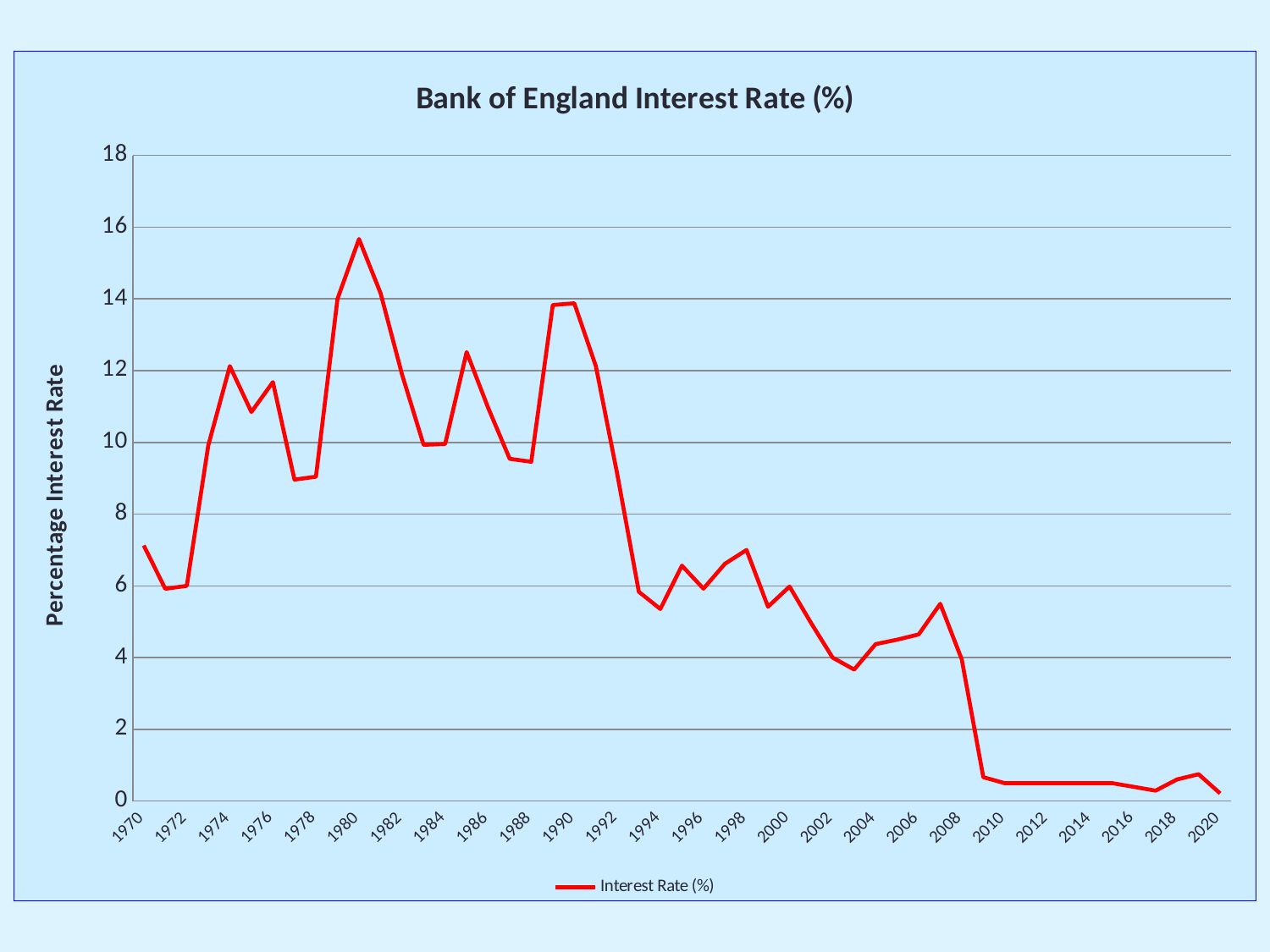
What is the label on the vertical axis? Percentage Interest Rate Is the interest rate for 2000 greater or less than 8? less Is the interest rate for 2010 greater or less than 2? less Which year has the higher interest rate, 1980 or 1990? 1980 How many series does the legend list? 1 What is the title of the chart? Bank of England Interest Rate (%) Does the interest rate rise or fall between 2008 and 2010? fall Is the interest rate for 1974 greater or less than 10? greater In which year does the interest rate reach its highest value? 1980 Which year has the higher interest rate, 1970 or 2010? 1970 What kind of chart is shown on the slide? line chart